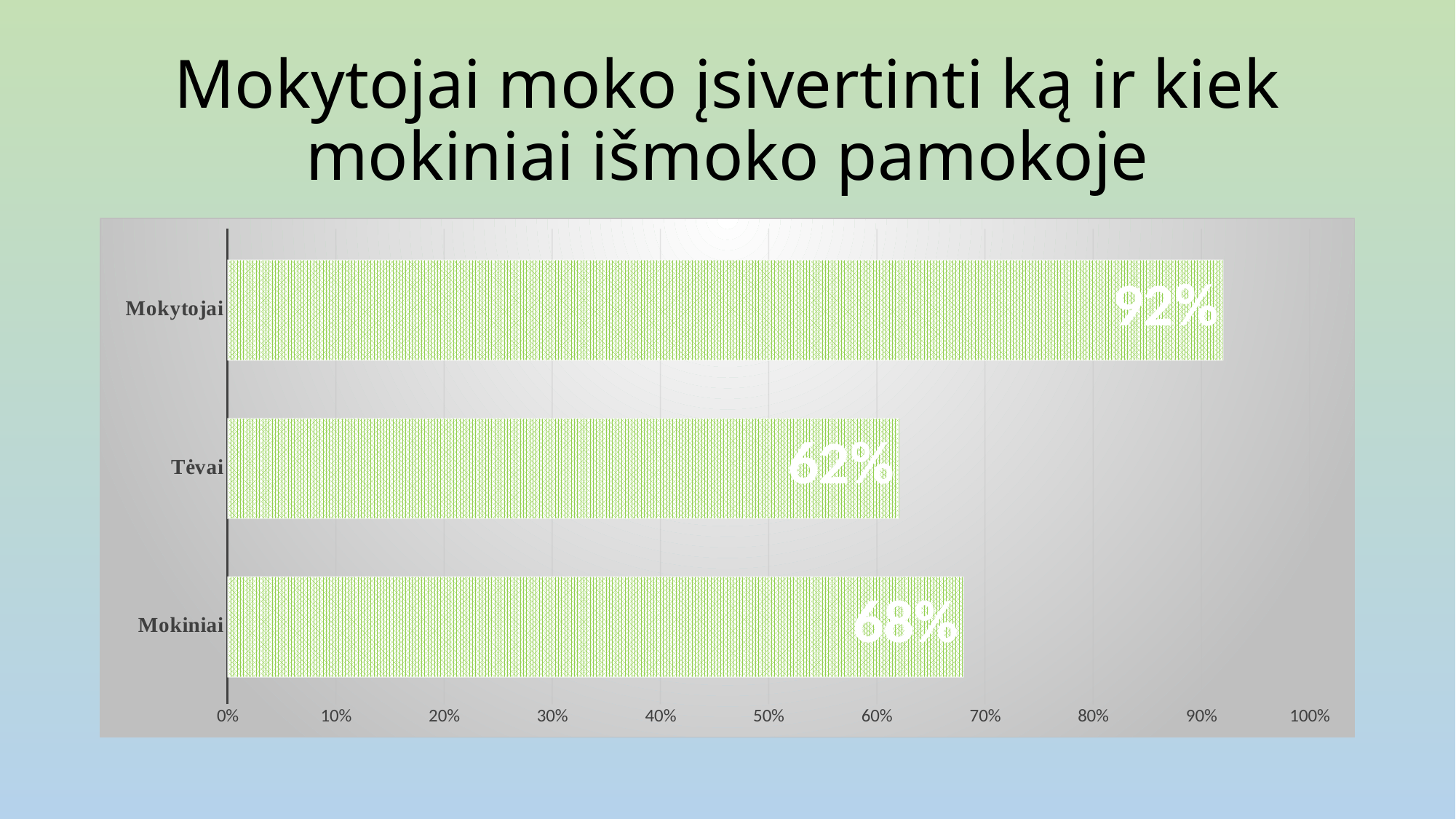
How many categories are shown in the chart? 3 What kind of chart is shown on the slide? bar chart What is the difference between the values for Mokiniai and Tėvai? 6% What is the value for Tėvai? 62% Which category has the highest value? Mokytojai What is the difference between the values for Mokytojai and Tėvai? 30% What is the value for Mokytojai? 92% What is the title of the slide? Mokytojai moko įsivertinti ką ir kiek mokiniai išmoko pamokoje Is the value for Mokytojai greater or less than 90%? greater Which category has the lowest value? Tėvai What is the value for Mokiniai? 68% Which is larger, the value for Mokiniai or the value for Tėvai? Mokiniai